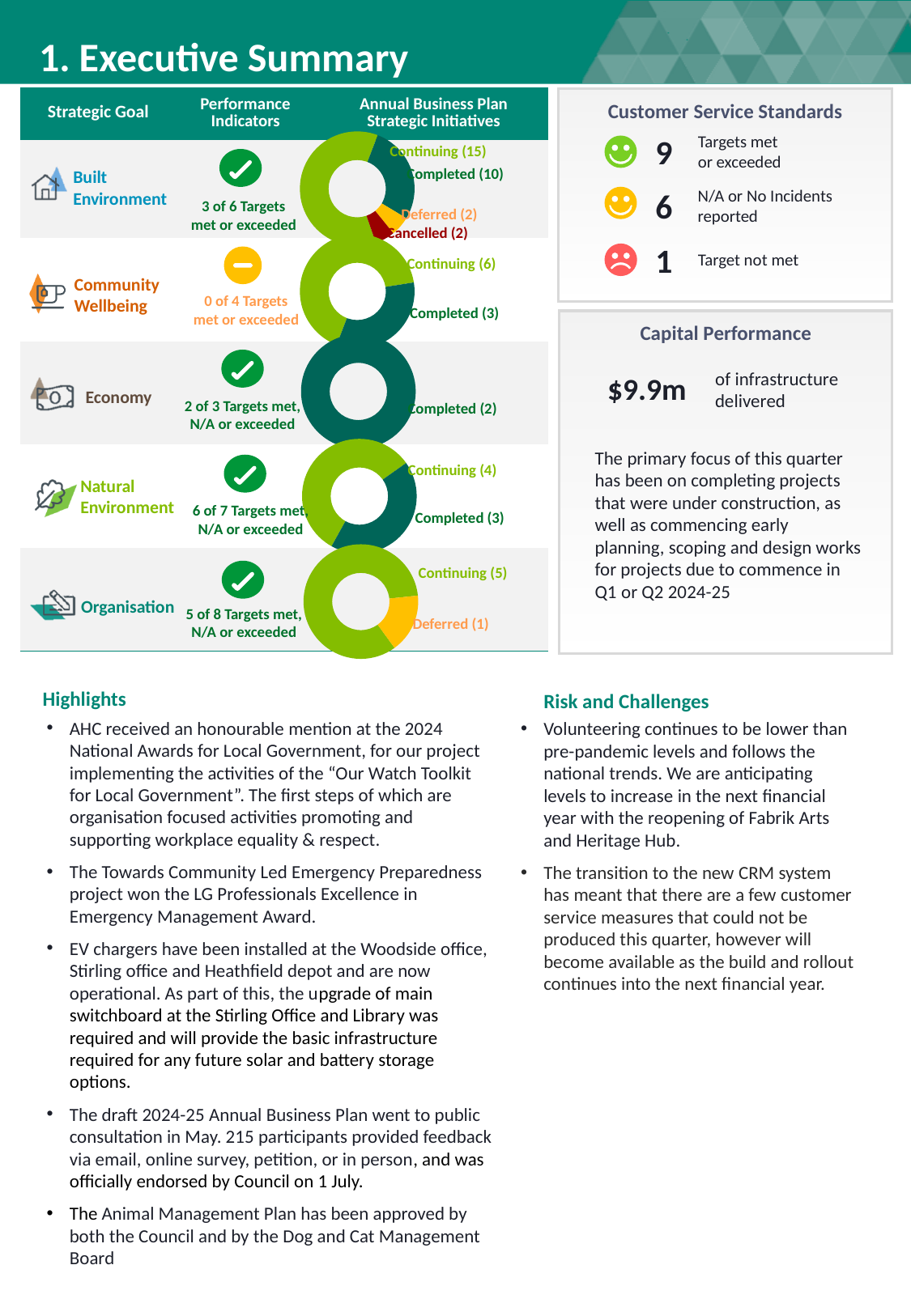
In the Economy donut chart, how many initiatives are Completed? 2 In the Economy donut chart, how many categories are shown? 1 In the Community Wellbeing donut chart, how many initiatives are Completed? 3 In the Organisation donut chart, which category has the smallest number of initiatives? Deferred In the Natural Environment donut chart, which is larger, Continuing or Completed? Continuing In the Built Environment donut chart, how many strategic initiatives are Continuing? 15 In the Built Environment donut chart, how many strategic initiatives are Cancelled? 2 In the Built Environment donut chart, which category has the largest number of initiatives? Continuing What type of chart is used to show the Annual Business Plan Strategic Initiatives for each strategic goal? Donut (pie) chart In the Built Environment donut chart, what is the total number of strategic initiatives across all categories? 29 In the Organisation donut chart, how many initiatives are Deferred? 1 In the Community Wellbeing donut chart, what is the difference between Continuing and Completed initiatives? 3